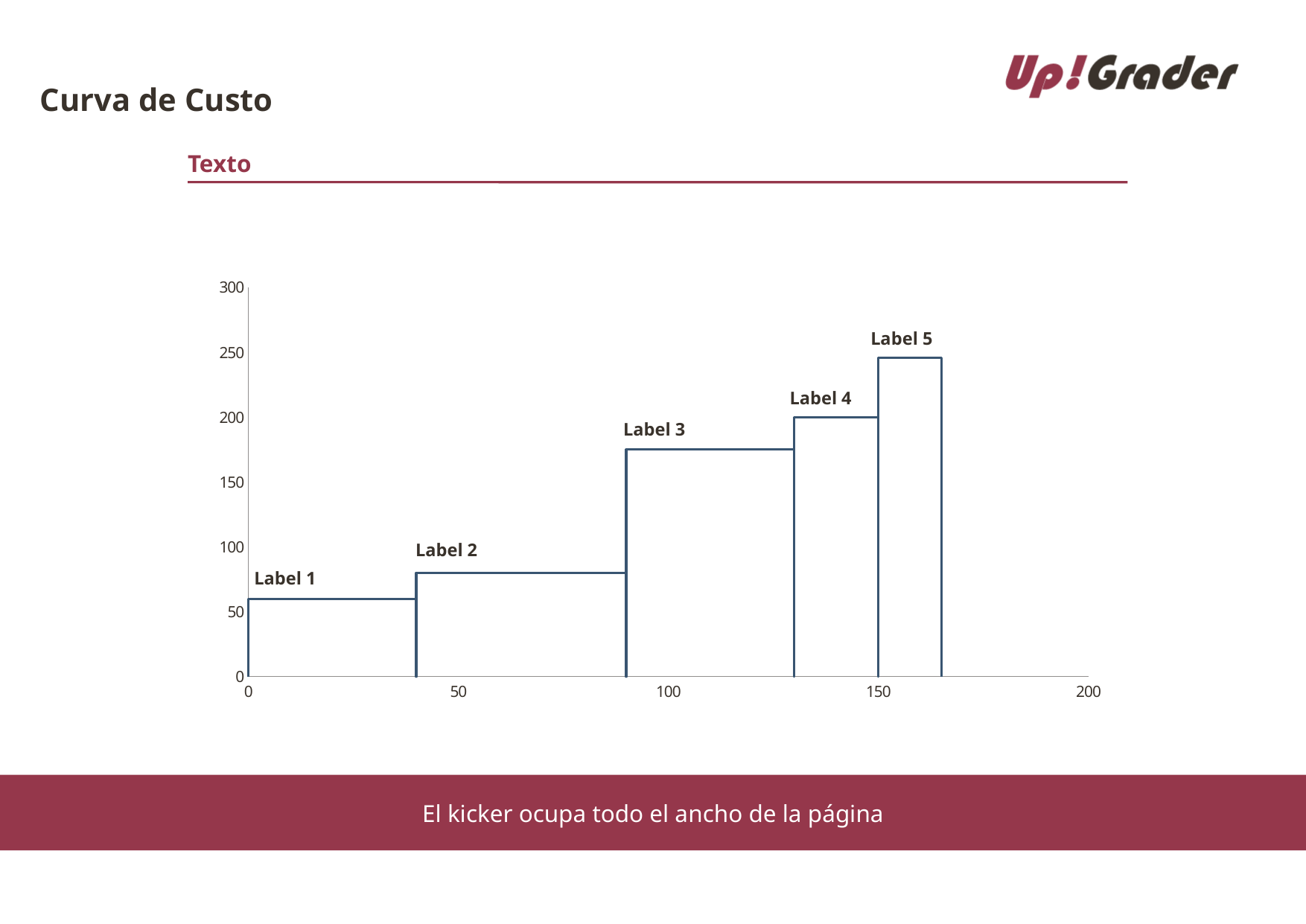
How many labeled steps are shown on the chart? 5 At what x-axis value does the Label 5 step begin? 150 Is the value for Label 2 greater or less than 50? greater Is the value for Label 3 greater or less than 150? greater Is the value for Label 1 greater or less than 100? less Do the values rise or fall from left to right along the x axis? rise Which label has the lowest value on the chart? Label 1 What is the title of the slide containing the chart? Curva de Custo Which label has the highest value on the chart? Label 5 What kind of chart is shown on the slide? step chart Which is larger, the value for Label 2 or the value for Label 4? Label 4